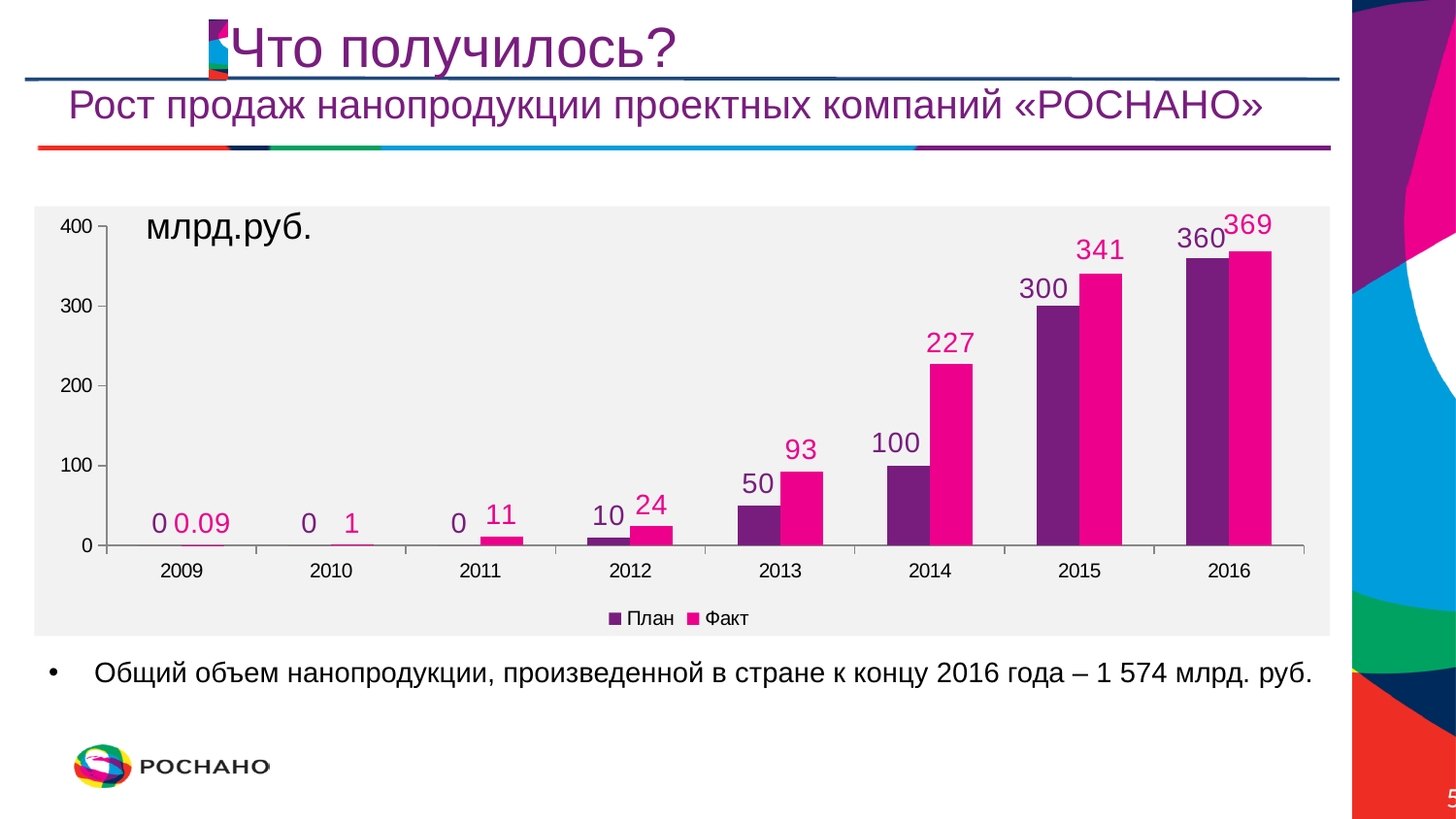
What is the План value for 2015? 300 Which is larger, the Факт value for 2014 or the План value for 2015? План value for 2015 Do the Факт values rise or fall from 2009 to 2016? rise What is the Факт value for 2014? 227 What kind of chart is shown on the slide? bar chart Is the Факт value for 2015 greater or less than 300? greater What is the difference between the Факт and План values for 2013? 43 What is the Факт value for 2009? 0.09 How many years are shown on the x axis? 8 Which year has the highest Факт value? 2016 What is the difference between the Факт values for 2016 and 2015? 28 How many series does the legend list? 2